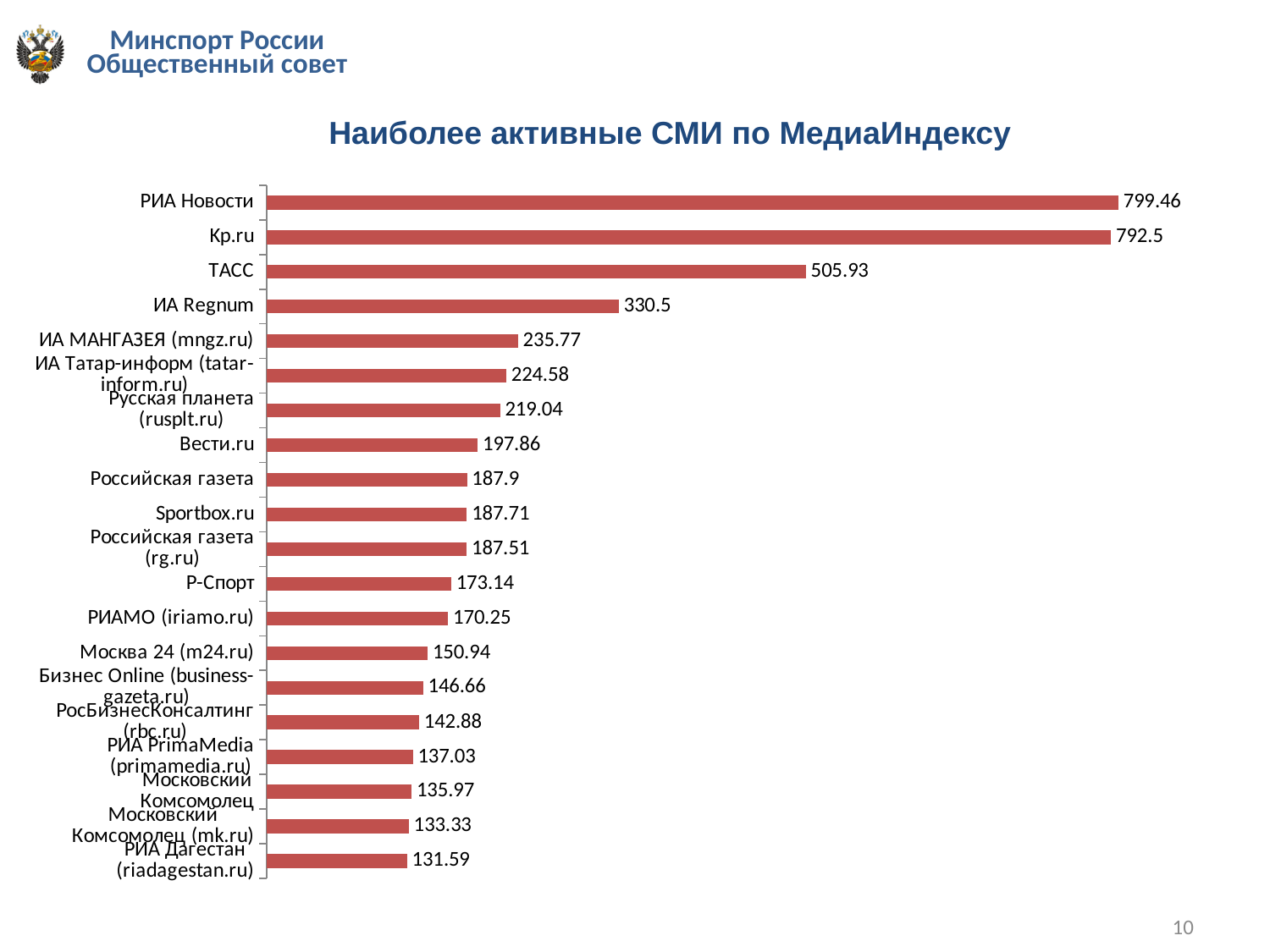
How many media outlets (categories) are shown in the chart? 20 What is the value for Москва 24 (m24.ru)? 150.94 Which media outlet has the highest value in the chart? РИА Новости What is the value for Sportbox.ru? 187.71 Which has a larger value, Вести.ru or Р-Спорт? Вести.ru What is the title of the chart? Наиболее активные СМИ по МедиаИндексу What is the value for РИА Новости? 799.46 Do the values increase or decrease going from the top bar to the bottom bar? Decrease Which media outlet has the lowest value in the chart? РИА Дагестан (riadagestan.ru) What is the difference between the values for ТАСС and ИА Regnum? 175.43 What type of chart is shown on the slide? Bar chart What is the value for ТАСС? 505.93